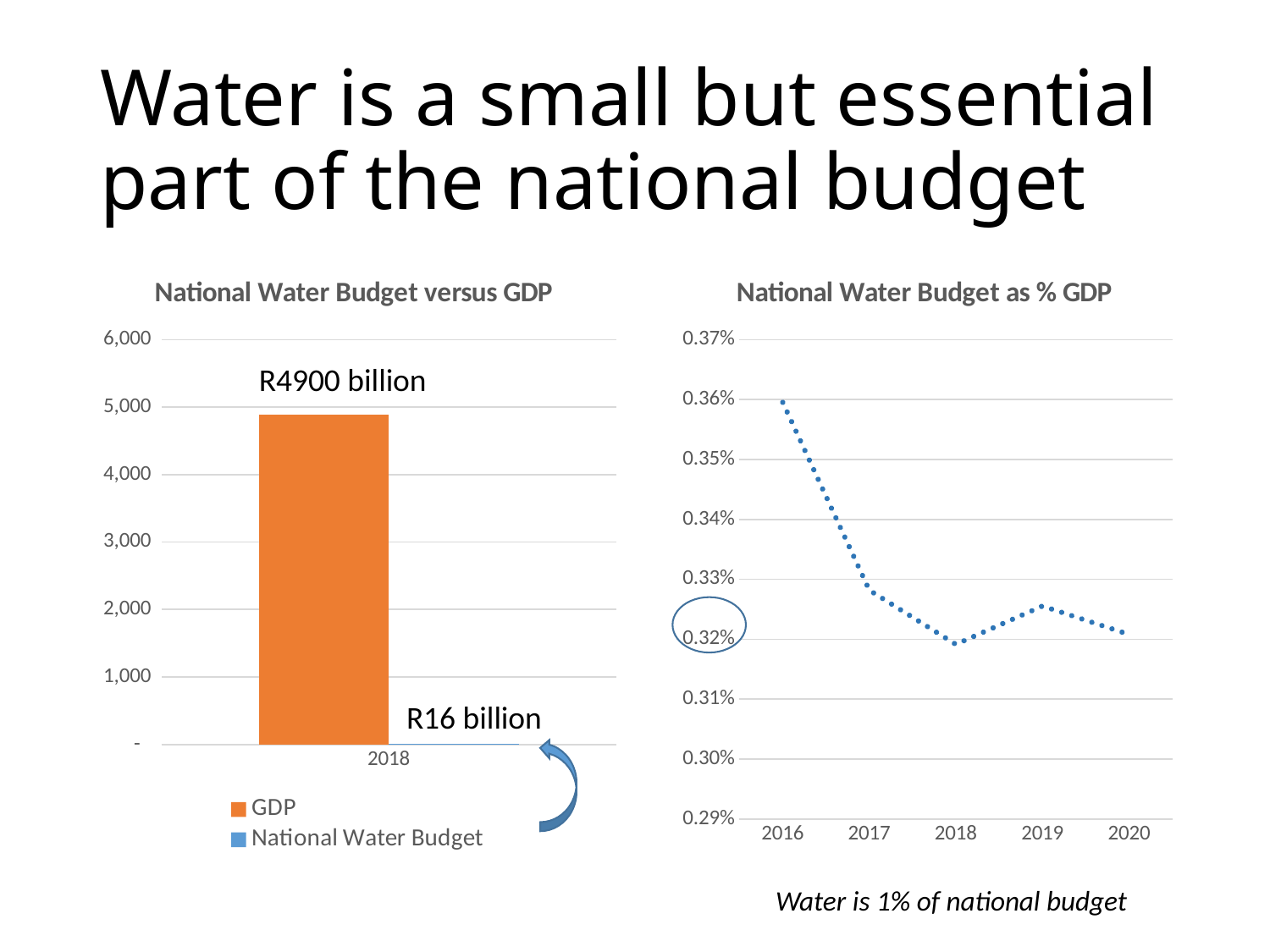
In the 'National Water Budget versus GDP' chart, what is the difference between GDP and the National Water Budget? R4884 billion How many series does the legend of the 'National Water Budget versus GDP' chart list? 2 In the 'National Water Budget as % GDP' chart, is the value for 2016 greater or less than 0.35%? greater In the 'National Water Budget as % GDP' chart, which year has the highest value? 2016 In the 'National Water Budget versus GDP' chart, which series is larger, GDP or National Water Budget? GDP In the 'National Water Budget as % GDP' chart, do the values generally rise or fall from 2016 to 2020? Fall In the 'National Water Budget as % GDP' chart, is the value for 2018 greater or less than 0.33%? less What kind of chart is the 'National Water Budget versus GDP' chart? Bar chart What kind of chart is the 'National Water Budget as % GDP' chart? Line chart In the 'National Water Budget versus GDP' chart, what is the value shown for the National Water Budget? R16 billion In the 'National Water Budget versus GDP' chart, what is the value shown for GDP? R4900 billion In the 'National Water Budget versus GDP' chart, which year is shown on the x axis? 2018